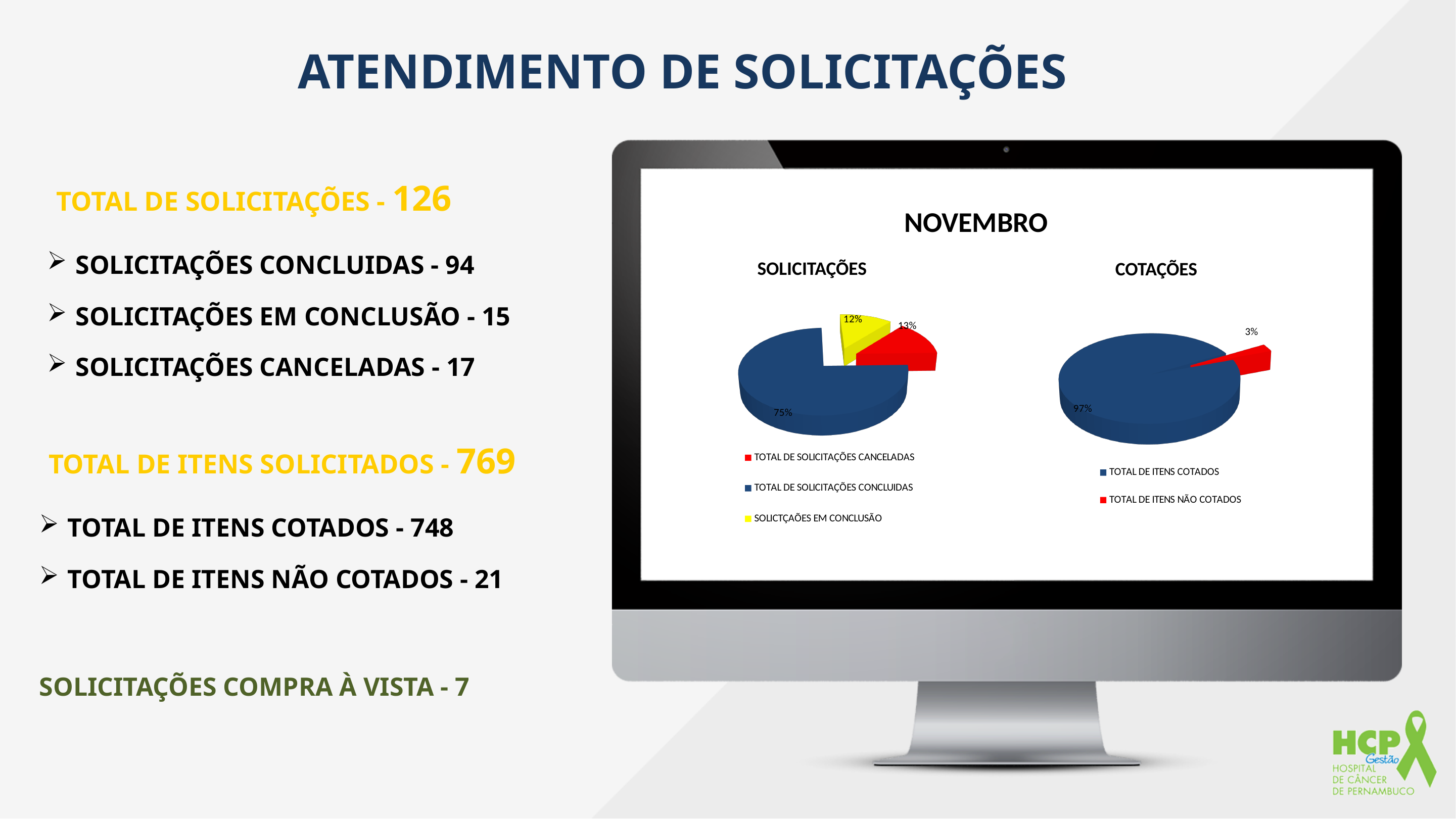
In the SOLICITAÇÕES chart, which category has the largest slice? TOTAL DE SOLICITAÇÕES CONCLUIDAS What kind of chart is the COTAÇÕES chart? Pie chart In the SOLICITAÇÕES chart, what share of the pie is TOTAL DE SOLICITAÇÕES CANCELADAS? 13% In the COTAÇÕES chart, what share of the pie is TOTAL DE ITENS COTADOS? 97% In the COTAÇÕES chart, which category has the smallest slice? TOTAL DE ITENS NÃO COTADOS In the COTAÇÕES chart, what share of the pie is TOTAL DE ITENS NÃO COTADOS? 3% In the SOLICITAÇÕES chart, which category has the smallest slice? SOLICTÇAÕES EM CONCLUSÃO How many slices does the SOLICITAÇÕES chart have? 3 In the SOLICITAÇÕES chart, what is the difference in percentage points between the CONCLUIDAS slice and the CANCELADAS slice? 62 What is the title shown above both charts on the monitor? NOVEMBRO